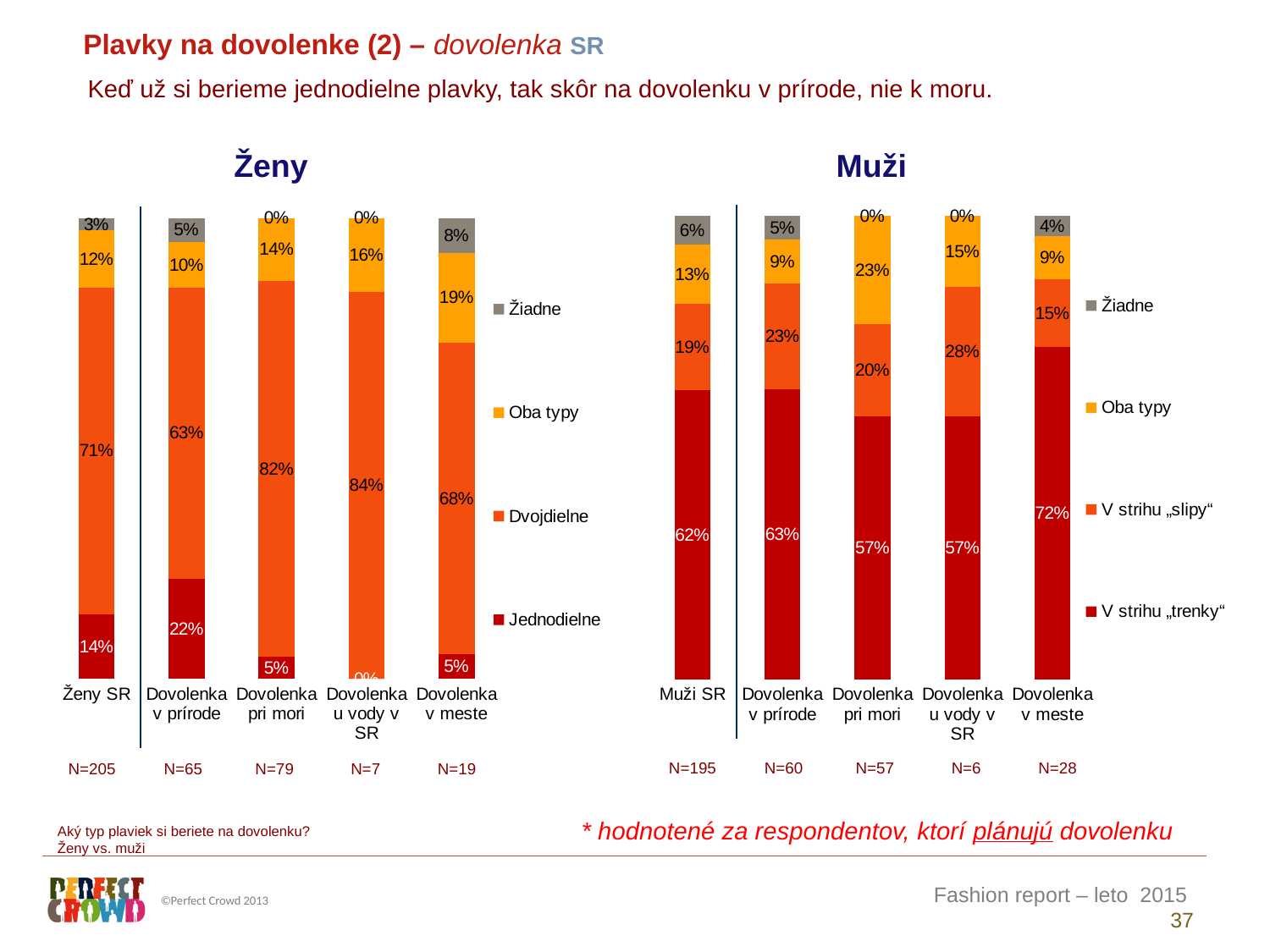
How many series does the legend of the Ženy chart list? 4 In the Muži chart, which is larger: the V strihu „trenky“ value for Muži SR or for Dovolenka pri mori? Muži SR In the Ženy chart, what is the difference between the Dvojdielne values for Ženy SR and Dovolenka v prírode? 8% In the Muži chart, which category has the lowest V strihu „slipy“ value? Dovolenka v meste What type of chart is the Ženy chart? Stacked bar chart In the Muži chart, what is the Žiadne value for Muži SR? 6% How many categories are shown on the x axis of the Muži chart? 5 In the Muži chart, what is the V strihu „trenky“ value for Dovolenka v meste? 72% In the Muži chart, what is the Oba typy value for Dovolenka pri mori? 23% In the Ženy chart, which category has the highest Dvojdielne value? Dovolenka u vody v SR In the Ženy chart, what is the Dvojdielne value for Dovolenka pri mori? 82% In the Ženy chart, what is the Jednodielne value for Dovolenka v prírode? 22%